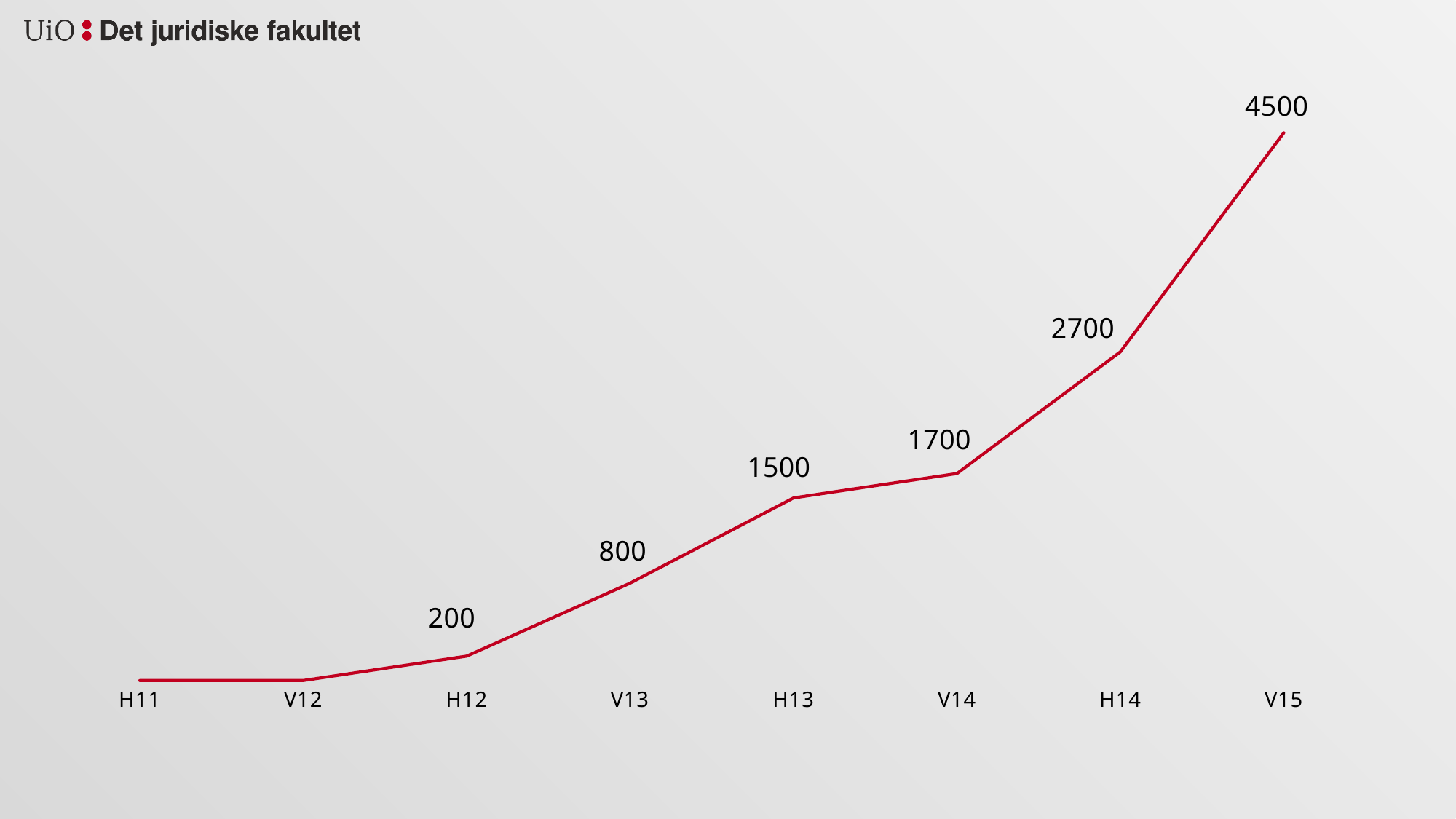
What is the difference between the values for V15 and H14? 1800 What is the value for H12? 200 What is the value for H14? 2700 What is the value for V13? 800 Which category has the highest value? V15 What is the value for H13? 1500 How many categories are shown on the x axis? 8 What is the value for V15? 4500 What kind of chart is this? Line chart Which is larger, the value for V13 or the value for V14? V14 Do the values rise or fall from H11 to V15? Rise What is the difference between the values for V14 and H13? 200